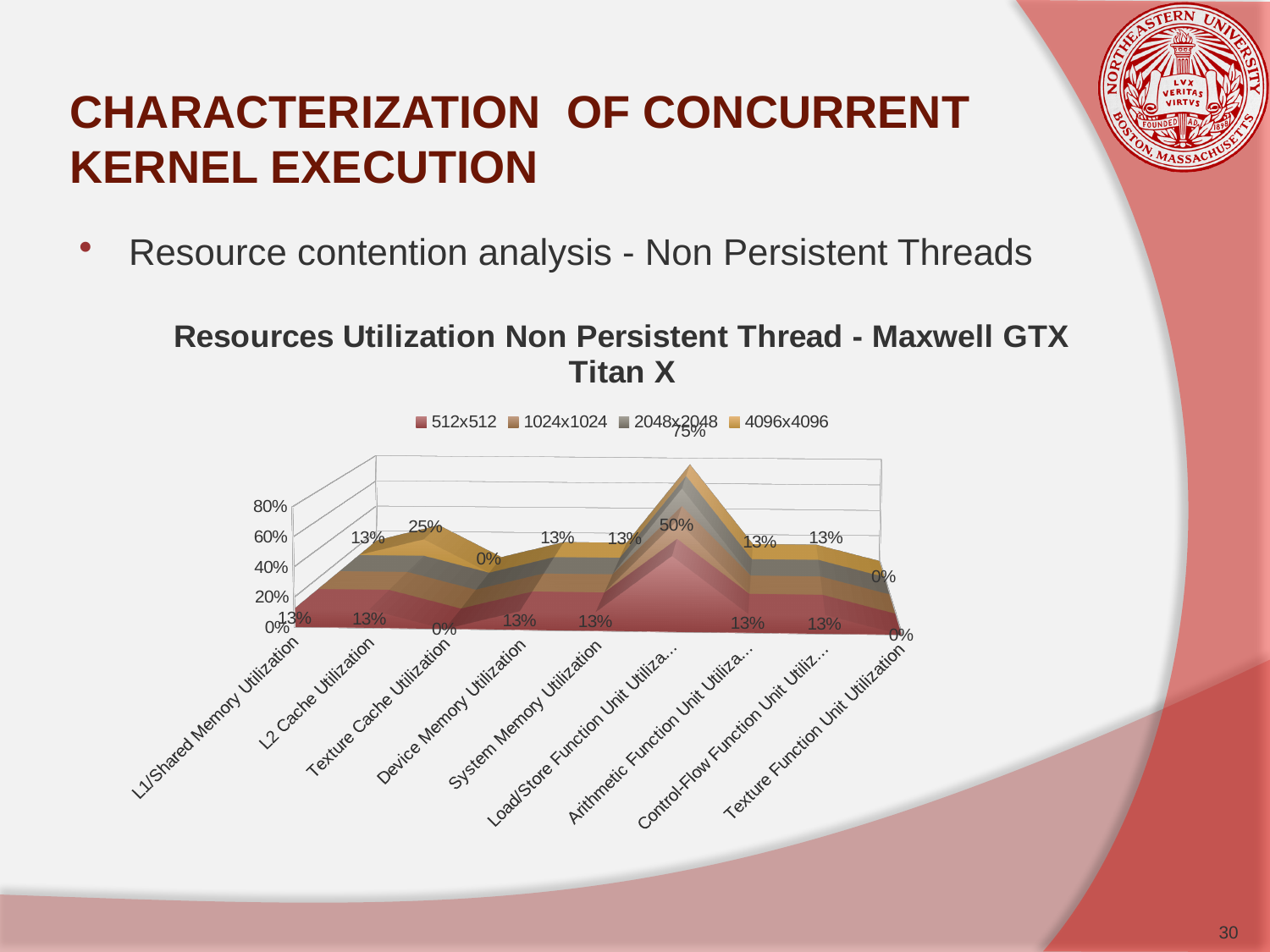
What is the value for L1/Shared Memory Utilization in the 512x512 series? 13% How many resource categories are plotted along the x axis? 9 In the 512x512 series, which is larger: Load/Store Function Unit Utilization or L2 Cache Utilization? Load/Store Function Unit Utilization What kind of chart is shown on the slide? area chart What is the highest data label value shown on the chart? 75% Which series are listed in the chart legend? 512x512, 1024x1024, 2048x2048, 4096x4096 What is the value for Load/Store Function Unit Utilization in the 512x512 series? 50% What is the difference between the 75% and 50% values labeled at Load/Store Function Unit Utilization? 25% Which category has the highest utilization in the chart? Load/Store Function Unit Utilization What is the title of the chart? Resources Utilization Non Persistent Thread - Maxwell GTX Titan X How many series does the chart legend list? 4 What is the value for Texture Cache Utilization in the 512x512 series? 0%